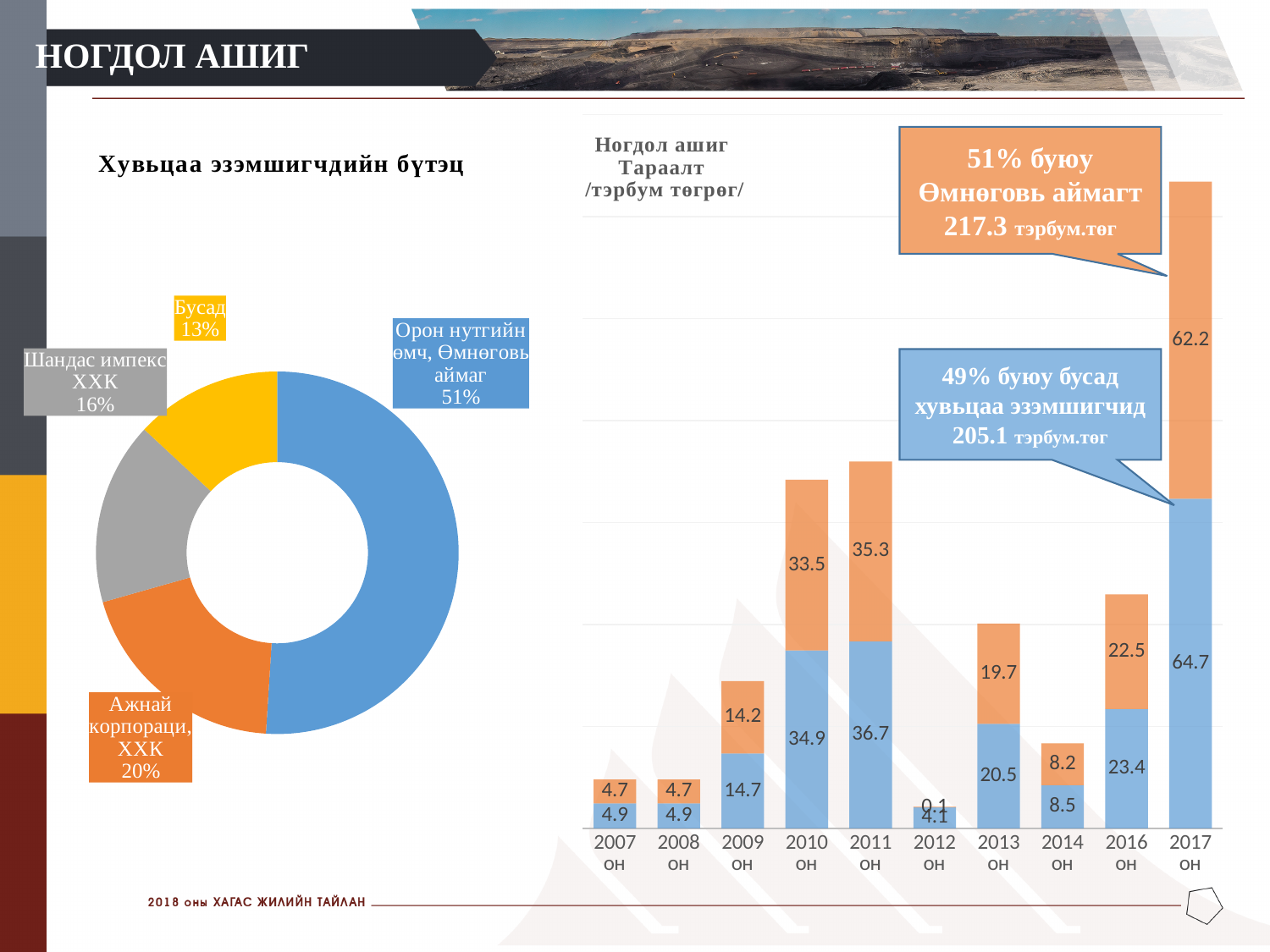
In the pie chart 'Хувьцаа эзэмшигчдийн бүтэц', which shareholder has the smallest share? Бусад In the 'Ногдол ашиг Тараалт' chart, how many years are shown on the x axis? 10 In the 'Ногдол ашиг Тараалт' chart, is the blue segment for 2011 он larger or smaller than the blue segment for 2013 он? Larger In the 'Ногдол ашиг Тараалт' chart, which year has the tallest stacked bar? 2017 он In the pie chart 'Хувьцаа эзэмшигчдийн бүтэц', how many slices are there? 4 In the 'Ногдол ашиг Тараалт' chart, what is the value of the orange (top) segment for 2010 он? 33.5 In the 'Ногдол ашиг Тараалт' chart, what is the total of the stacked bar for 2017 он? 126.9 In the pie chart 'Хувьцаа эзэмшигчдийн бүтэц', what is the share of 'Ажнай корпораци, ХХК'? 20% What kind of chart is the 'Ногдол ашиг Тараалт' chart on the right? Stacked bar chart In the pie chart 'Хувьцаа эзэмшигчдийн бүтэц', what is the difference between the shares of 'Шандас импекс ХХК' and 'Бусад'? 3% In the pie chart 'Хувьцаа эзэмшигчдийн бүтэц', what share does 'Орон нутгийн өмч, Өмнөговь аймаг' hold? 51% In the 'Ногдол ашиг Тараалт' chart, what is the value of the blue (bottom) segment for 2017 он? 64.7